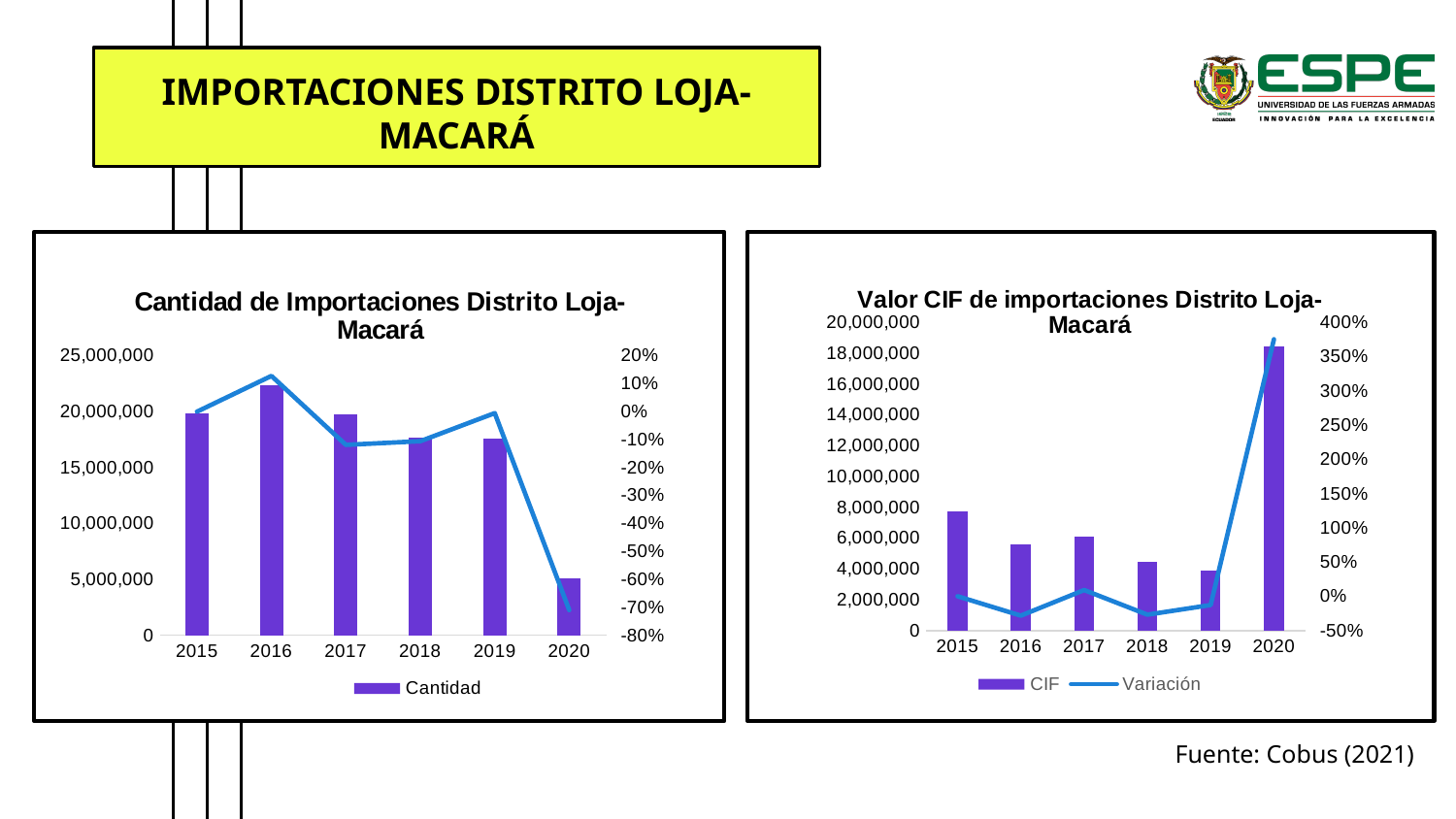
In the chart 'Valor CIF de importaciones Distrito Loja-Macará', is the bar for 2018 greater or less than 6,000,000? less In the chart 'Cantidad de Importaciones Distrito Loja-Macará', is the bar for 2016 greater or less than 20,000,000? greater In the chart 'Valor CIF de importaciones Distrito Loja-Macará', is the bar for 2020 greater or less than 16,000,000? greater In the chart 'Valor CIF de importaciones Distrito Loja-Macará', which year has the shortest bar? 2019 In the chart 'Cantidad de Importaciones Distrito Loja-Macará', which bar is taller, 2015 or 2020? 2015 In the chart 'Cantidad de Importaciones Distrito Loja-Macará', which year has the tallest bar? 2016 In the chart 'Valor CIF de importaciones Distrito Loja-Macará', how many series does the legend list? 2 In the chart 'Cantidad de Importaciones Distrito Loja-Macará', how many years are shown on the x axis? 6 In the chart 'Valor CIF de importaciones Distrito Loja-Macará', which year has the tallest bar? 2020 In the chart 'Valor CIF de importaciones Distrito Loja-Macará', what are the two legend entries? CIF and Variación In the chart 'Cantidad de Importaciones Distrito Loja-Macará', which year has the shortest bar? 2020